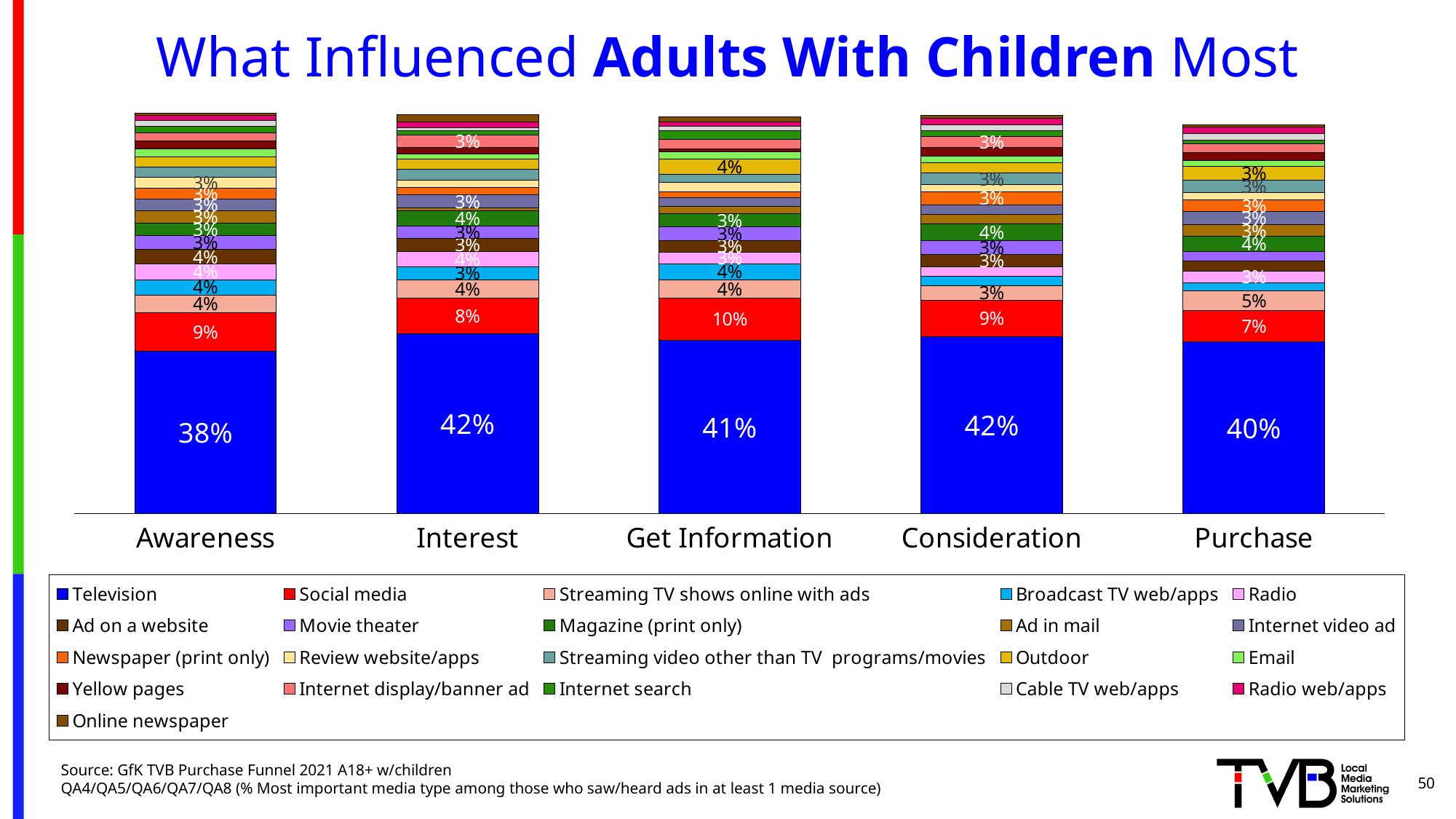
What is the Television value for the Awareness stage? 38% What is the difference between the Television values for Interest and Awareness? 4 percentage points Which stage has the lowest Television value? Awareness What is the Social media value for the Get Information stage? 10% Is the Social media value larger for Consideration or for Purchase? Consideration What is the title of the chart? What Influenced Adults With Children Most What is the Streaming TV shows online with ads value for the Purchase stage? 5% How many series does the legend list? 21 Which stage has the lowest Social media value? Purchase How many stages are shown along the x axis? 5 Which stage has the highest Social media value? Get Information What kind of chart is shown on the slide? Stacked bar chart